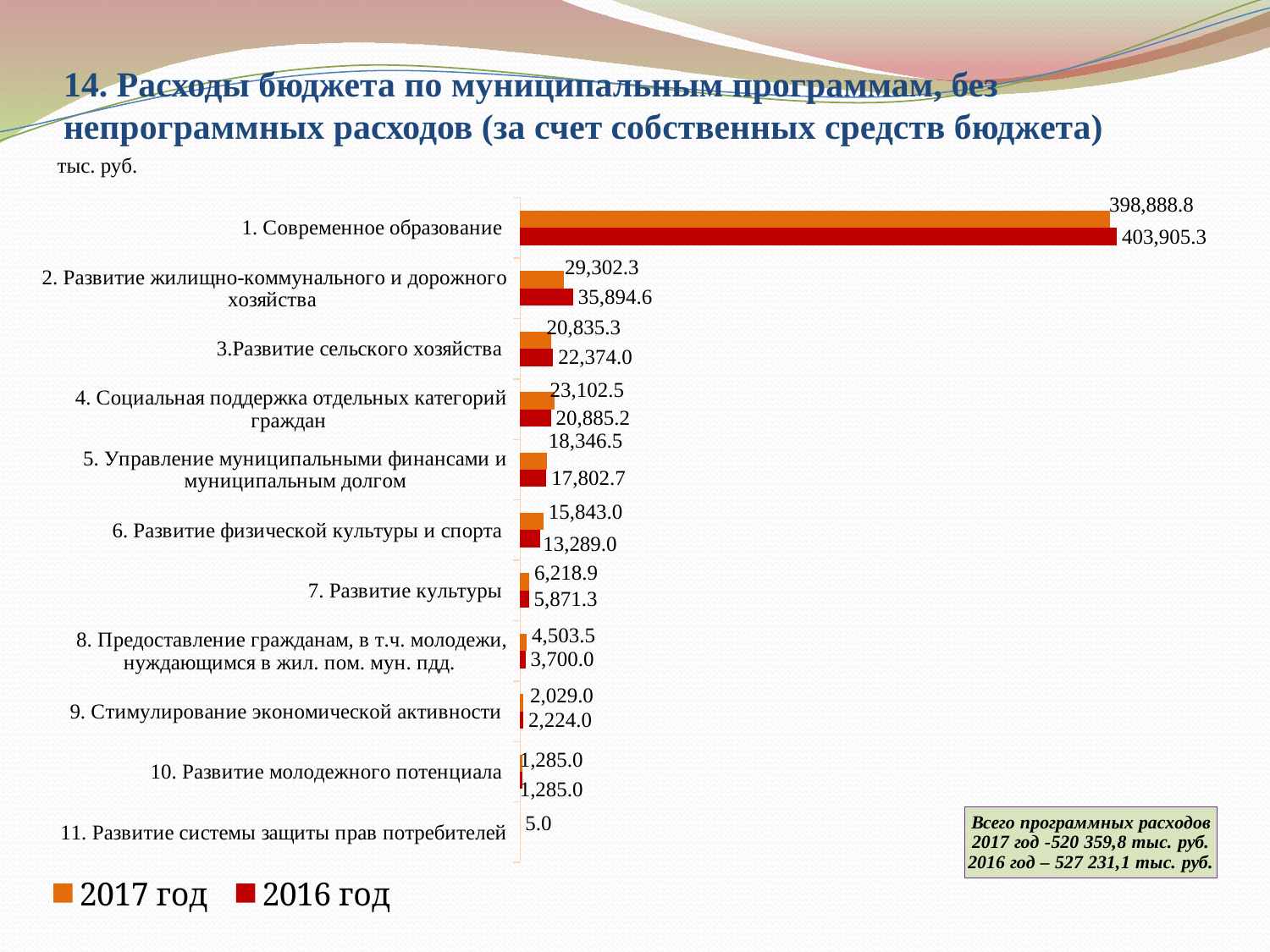
What is the 2017 год value for «6. Развитие физической культуры и спорта»? 15,843.0 Which program has the lowest 2017 год value? 11. Развитие системы защиты прав потребителей What is the difference between the 2016 год and 2017 год values for «1. Современное образование»? 5,016.5 What is the 2016 год value for «2. Развитие жилищно-коммунального и дорожного хозяйства»? 35,894.6 For «4. Социальная поддержка отдельных категорий граждан», which year has the larger value, 2017 год or 2016 год? 2017 год What is the 2016 год value for «9. Стимулирование экономической активности»? 2,224.0 What is the 2017 год value for «1. Современное образование»? 398,888.8 What is the difference between the 2017 год and 2016 год values for «6. Развитие физической культуры и спорта»? 2,554.0 Which program has the highest 2017 год value? 1. Современное образование What kind of chart is shown on the slide? Bar chart How many series does the legend list? 2 How many programs (categories) are shown on the chart? 11